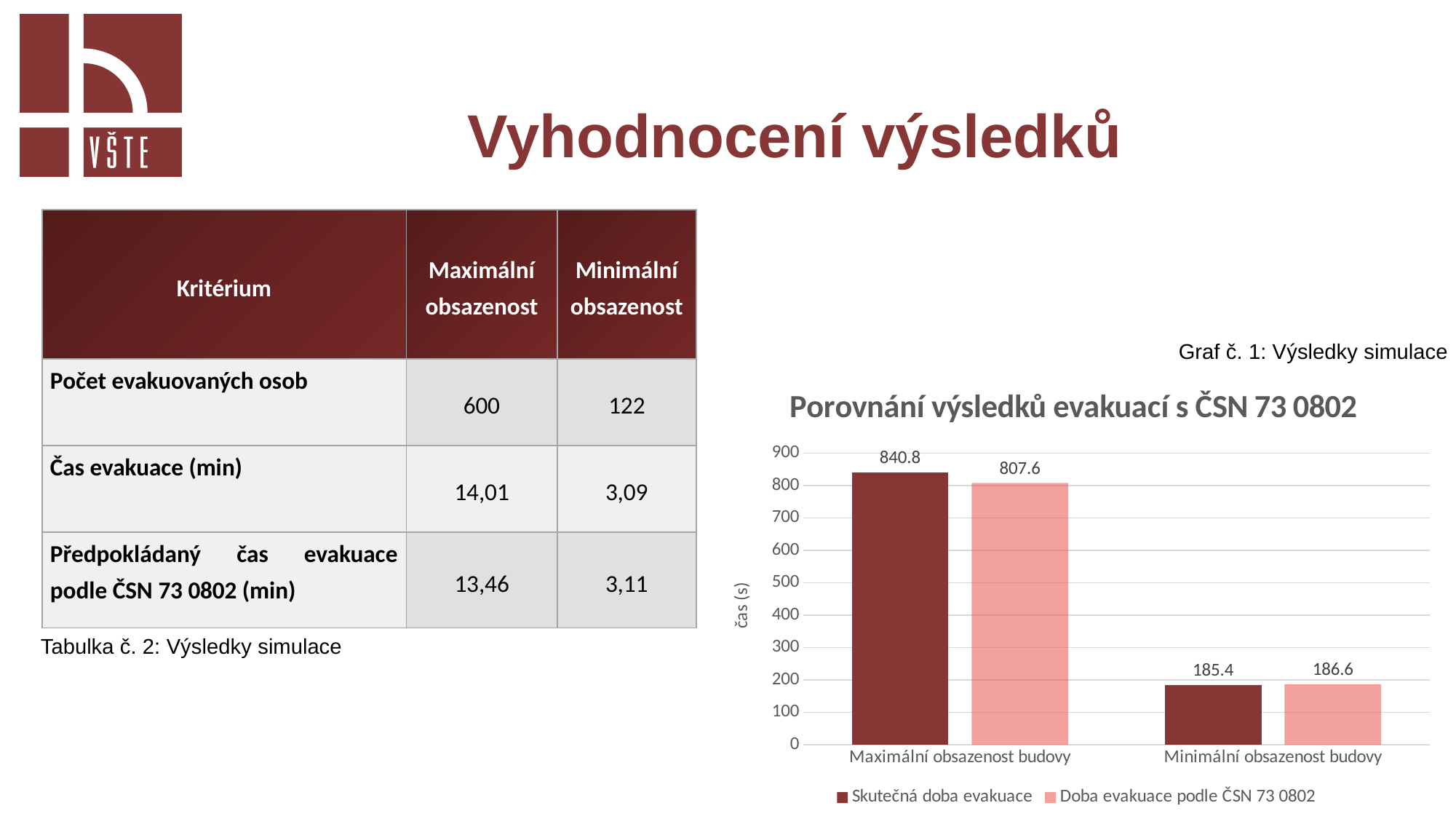
Which category has the highest Skutečná doba evakuace value? Maximální obsazenost budovy What is the value of Skutečná doba evakuace for Maximální obsazenost budovy? 840.8 What is the value of Skutečná doba evakuace for Minimální obsazenost budovy? 185.4 How many categories are shown on the x axis of the chart? 2 What is the value of Doba evakuace podle ČSN 73 0802 for Maximální obsazenost budovy? 807.6 How many series does the chart legend list? 2 What is the difference between Skutečná doba evakuace and Doba evakuace podle ČSN 73 0802 for Maximální obsazenost budovy? 33.2 Which category has the lowest Doba evakuace podle ČSN 73 0802 value? Minimální obsazenost budovy What is the value of Doba evakuace podle ČSN 73 0802 for Minimální obsazenost budovy? 186.6 What is the title of the chart? Porovnání výsledků evakuací s ČSN 73 0802 What kind of chart is shown on the slide? bar chart For Maximální obsazenost budovy, which is larger: Skutečná doba evakuace or Doba evakuace podle ČSN 73 0802? Skutečná doba evakuace